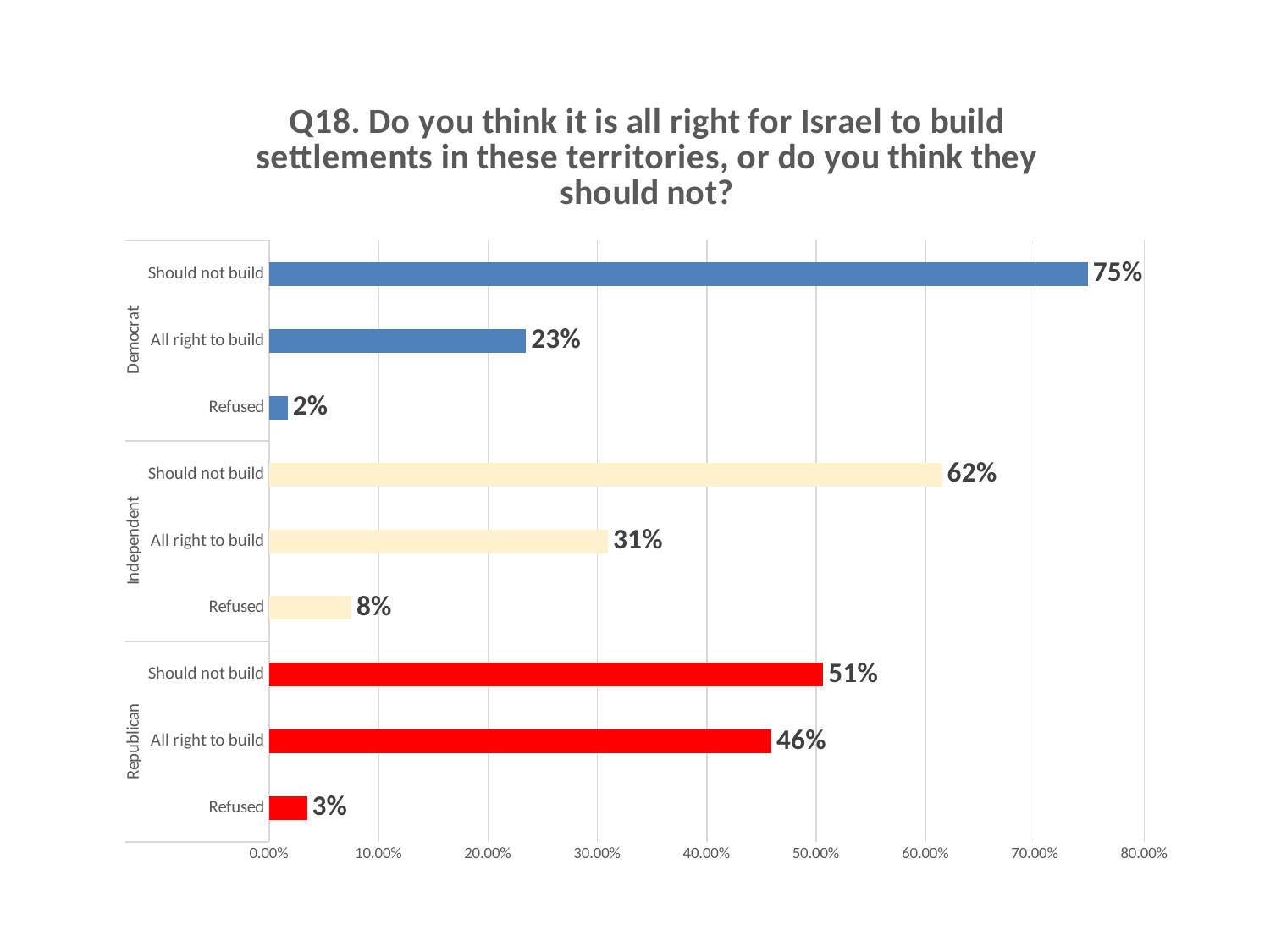
What percentage of Republicans said it is all right to build? 46% How many bars are plotted on the chart? 9 Which group and response has the lowest value on the chart? Democrat, Refused What colour are the bars for the Republican group? red What kind of chart is shown on the slide? bar chart Is the Independent 'Should not build' value greater or less than 60.00%? greater What is the difference between the Independent 'Should not build' and 'All right to build' values? 31% What is the difference between the Democrat and Republican 'Should not build' values? 24% What percentage of Democrats said Israel should not build settlements? 75% Which is larger: the Republican 'Should not build' value or the Republican 'All right to build' value? Should not build Which group and response has the highest value on the chart? Democrat, Should not build What percentage of Independents refused to answer? 8%